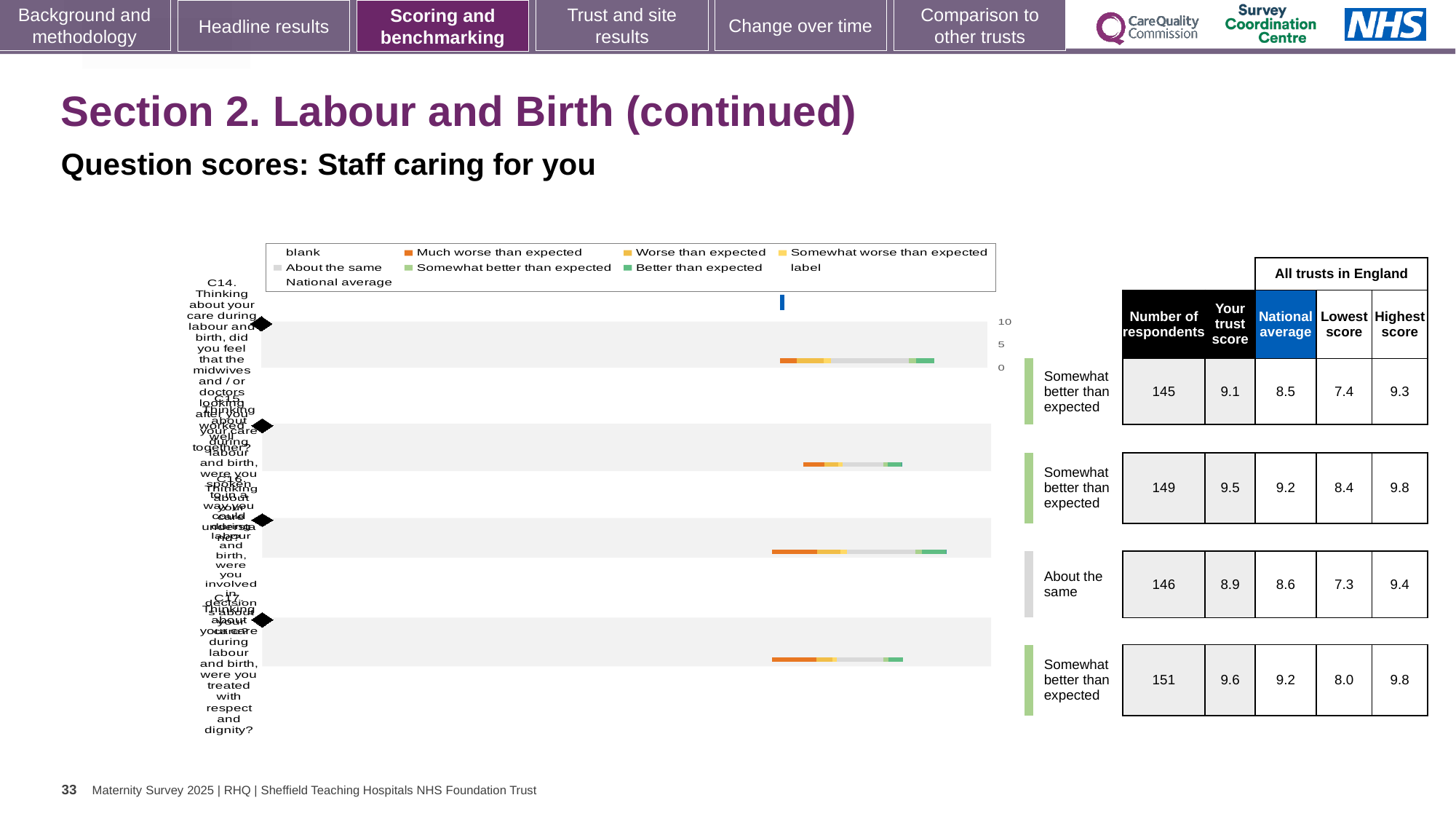
In the table beside the chart, what is the 'Your trust score' for the last row (C17, treated with respect and dignity)? 9.6 What is the highest tick value shown on the chart's axis? 10 In the table beside the chart, which row has the highest 'Your trust score'? the last row (C17) In the table beside the chart, is the number of respondents for the last row (151) larger than for the first row (145)? yes, 151 Which colour does the legend use for 'Much worse than expected'? orange What kind of chart is shown on the slide? bar chart How many question rows (bars) are plotted in the chart? 4 In the table beside the chart, what is the number of respondents for the first row (C14)? 145 In the table beside the chart, which row has the lowest 'Your trust score'? the third row (8.9) In the table beside the chart, what is the difference between the trust score and the national average for the first row (9.1 vs 8.5)? 0.6